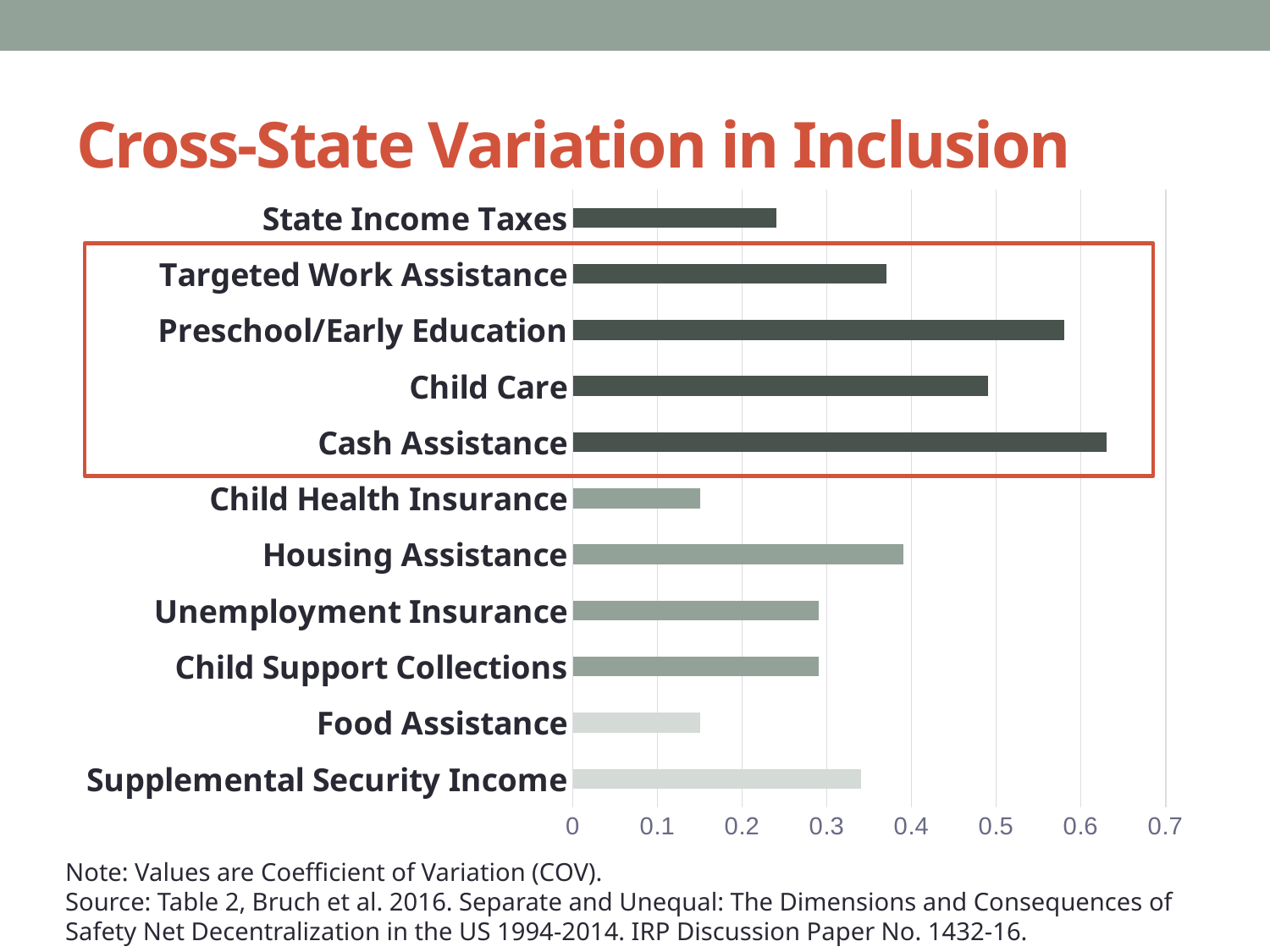
Which category has the highest value in the chart? Cash Assistance Is the value for Cash Assistance greater or less than 0.6? greater Is the value for Child Health Insurance greater or less than 0.2? less How many categories are plotted in the chart? 11 What is the title of the chart on the slide? Cross-State Variation in Inclusion What kind of chart is shown on the slide? Bar chart Is the value for Child Care greater or less than 0.4? greater Which is larger, the value for Preschool/Early Education or the value for Child Care? Preschool/Early Education Which is larger, the value for Housing Assistance or the value for Food Assistance? Housing Assistance